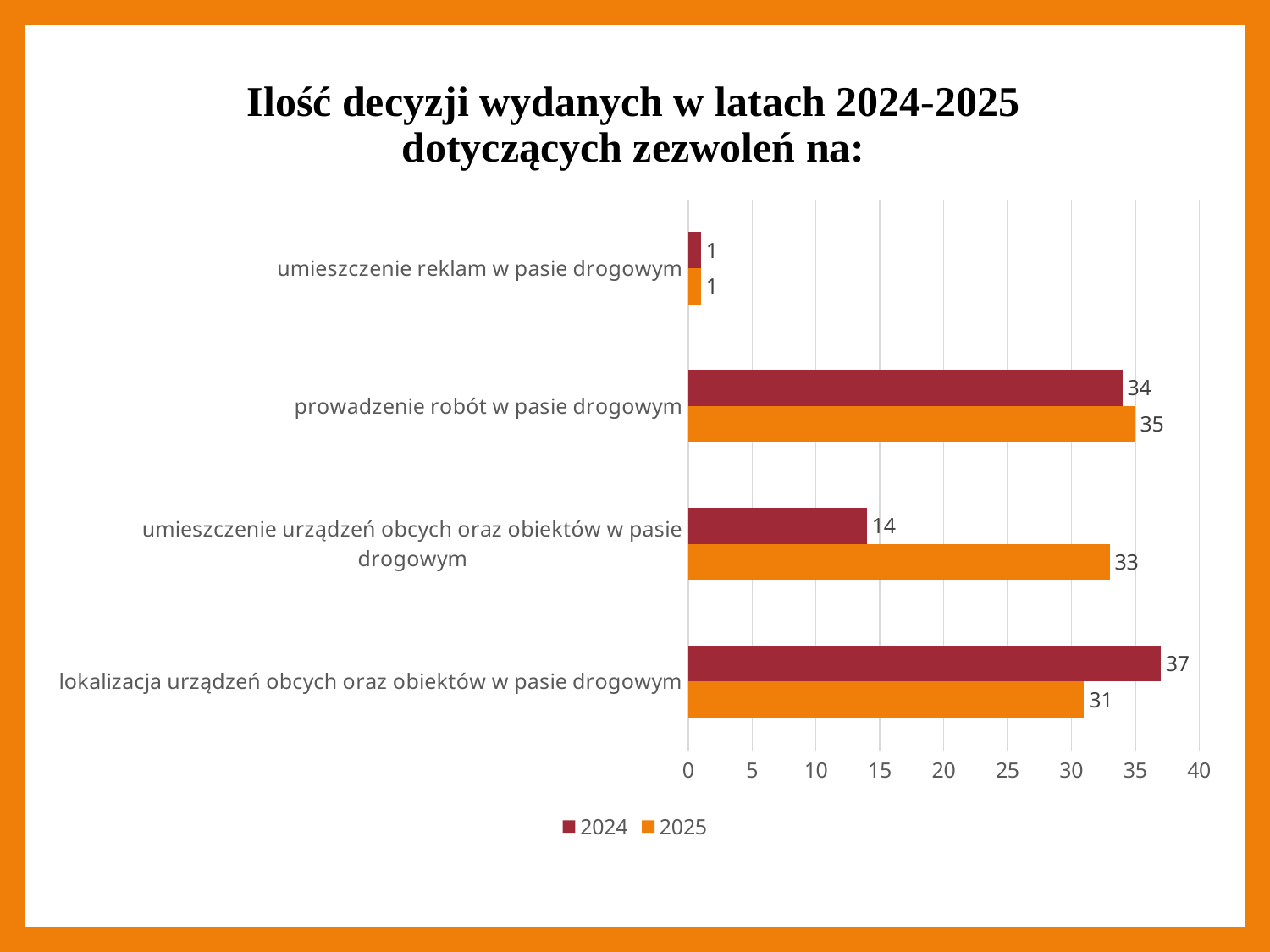
What is the 2025 value for "umieszczenie urządzeń obcych oraz obiektów w pasie drogowym"? 33 What is the 2025 value for "lokalizacja urządzeń obcych oraz obiektów w pasie drogowym"? 31 Which category has the highest 2024 value? lokalizacja urządzeń obcych oraz obiektów w pasie drogowym What is the 2024 value for "prowadzenie robót w pasie drogowym"? 34 For "lokalizacja urządzeń obcych oraz obiektów w pasie drogowym", which year has the larger value, 2024 or 2025? 2024 How many categories are shown on the chart? 4 How many series does the legend list? 2 What is the difference between the 2025 and 2024 values for "umieszczenie urządzeń obcych oraz obiektów w pasie drogowym"? 19 Which colour represents the 2025 series? orange Is the 2024 value for "umieszczenie urządzeń obcych oraz obiektów w pasie drogowym" greater or less than 20? less What kind of chart is shown on the slide? bar chart Which category has the lowest 2025 value? umieszczenie reklam w pasie drogowym